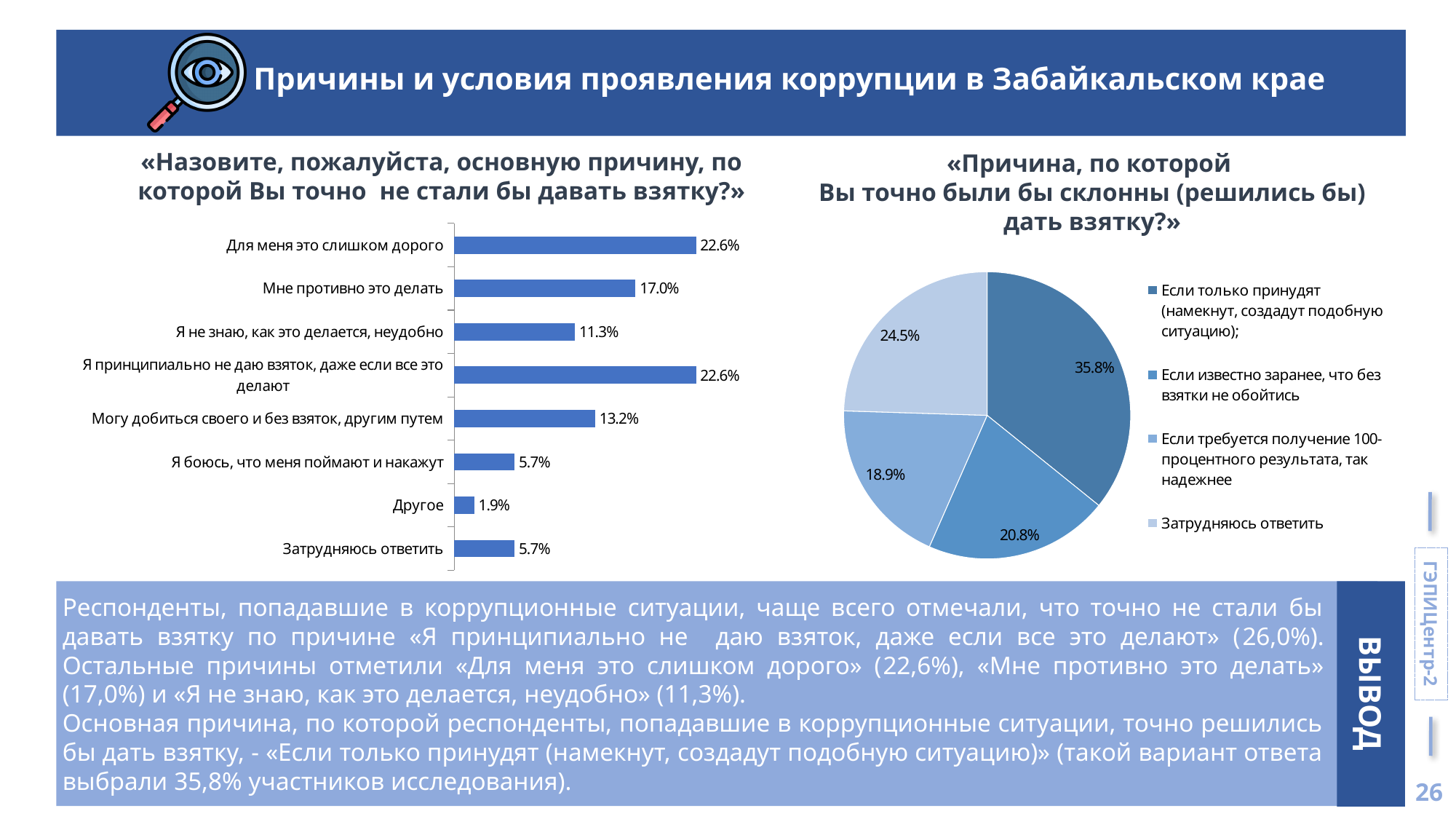
On the right pie chart, what is the value for «Затрудняюсь ответить»? 24.5% On the left bar chart, which category has the lowest value? Другое On the left bar chart, what is the value for «Я не знаю, как это делается, неудобно»? 11.3% What kind of chart is the chart on the right of the slide? pie chart How many entries does the legend of the right pie chart list? 4 On the left bar chart, what is the difference between «Для меня это слишком дорого» and «Могу добиться своего и без взяток, другим путем»? 9.4% On the left bar chart, which is larger: «Мне противно это делать» or «Могу добиться своего и без взяток, другим путем»? Мне противно это делать On the right pie chart, which slice is the smallest? Если требуется получение 100-процентного результата, так надежнее On the left bar chart, what is the value for «Мне противно это делать»? 17.0% What kind of chart is the chart on the left of the slide? bar chart On the right pie chart, what is the share for «Если только принудят (намекнут, создадут подобную ситуацию)»? 35.8% How many categories are shown on the left bar chart? 8